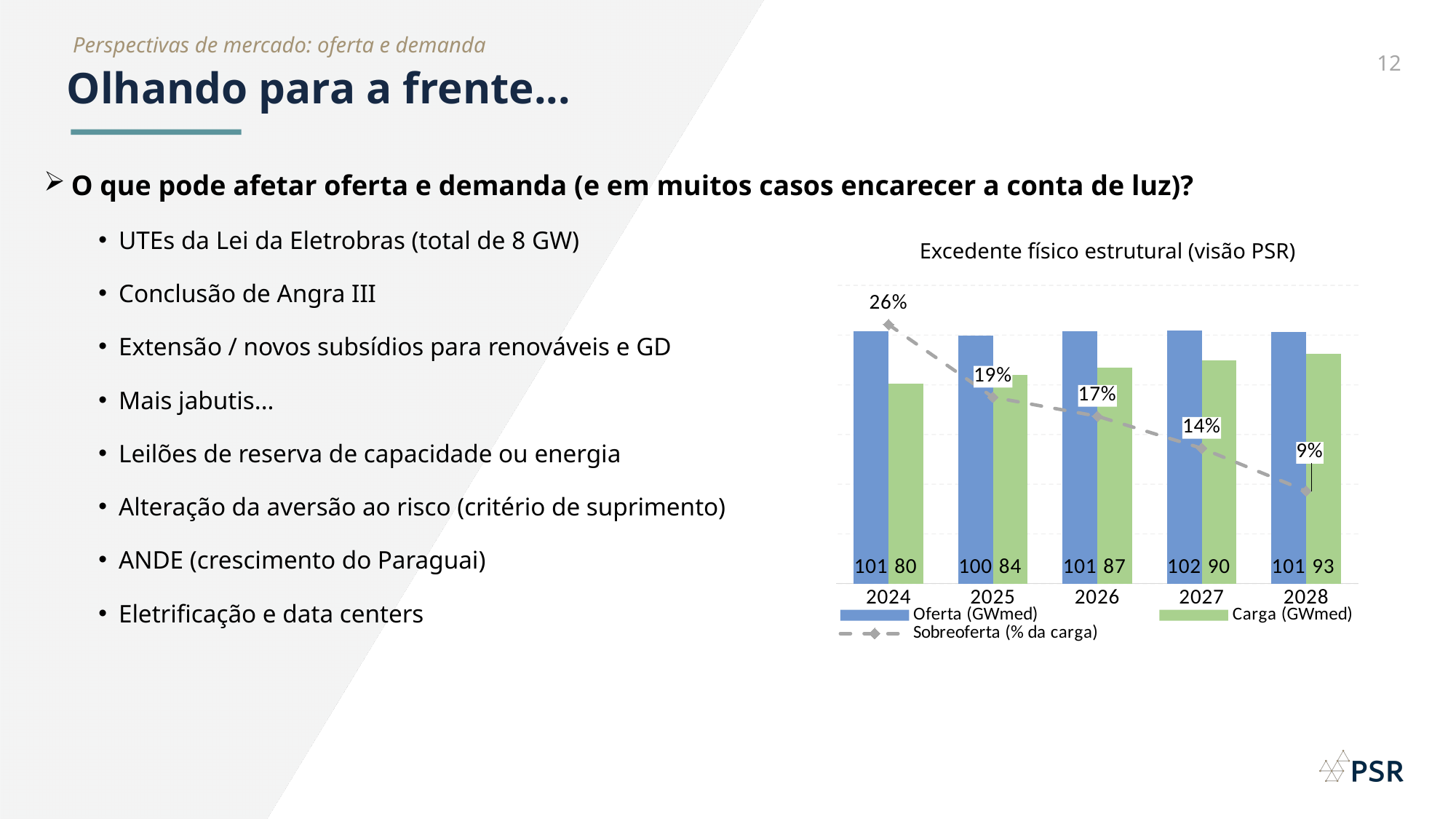
Does the Sobreoferta (% da carga) line rise or fall from 2024 to 2028? Fall What is the title of the chart on the slide? Excedente físico estrutural (visão PSR) What is the Carga (GWmed) value for 2028? 93 In which year is the Sobreoferta (% da carga) highest? 2024 How many years are shown on the x axis of the chart? 5 What is the difference between Oferta (GWmed) and Carga (GWmed) in 2025? 16 What is the Oferta (GWmed) value for 2024? 101 In which year is the Carga (GWmed) lowest? 2024 What kind of chart is used for the Oferta and Carga series? Bar chart How many series does the chart legend list? 3 Which is larger in 2027, Oferta (GWmed) or Carga (GWmed)? Oferta (GWmed) What is the Sobreoferta (% da carga) value for 2026? 17%